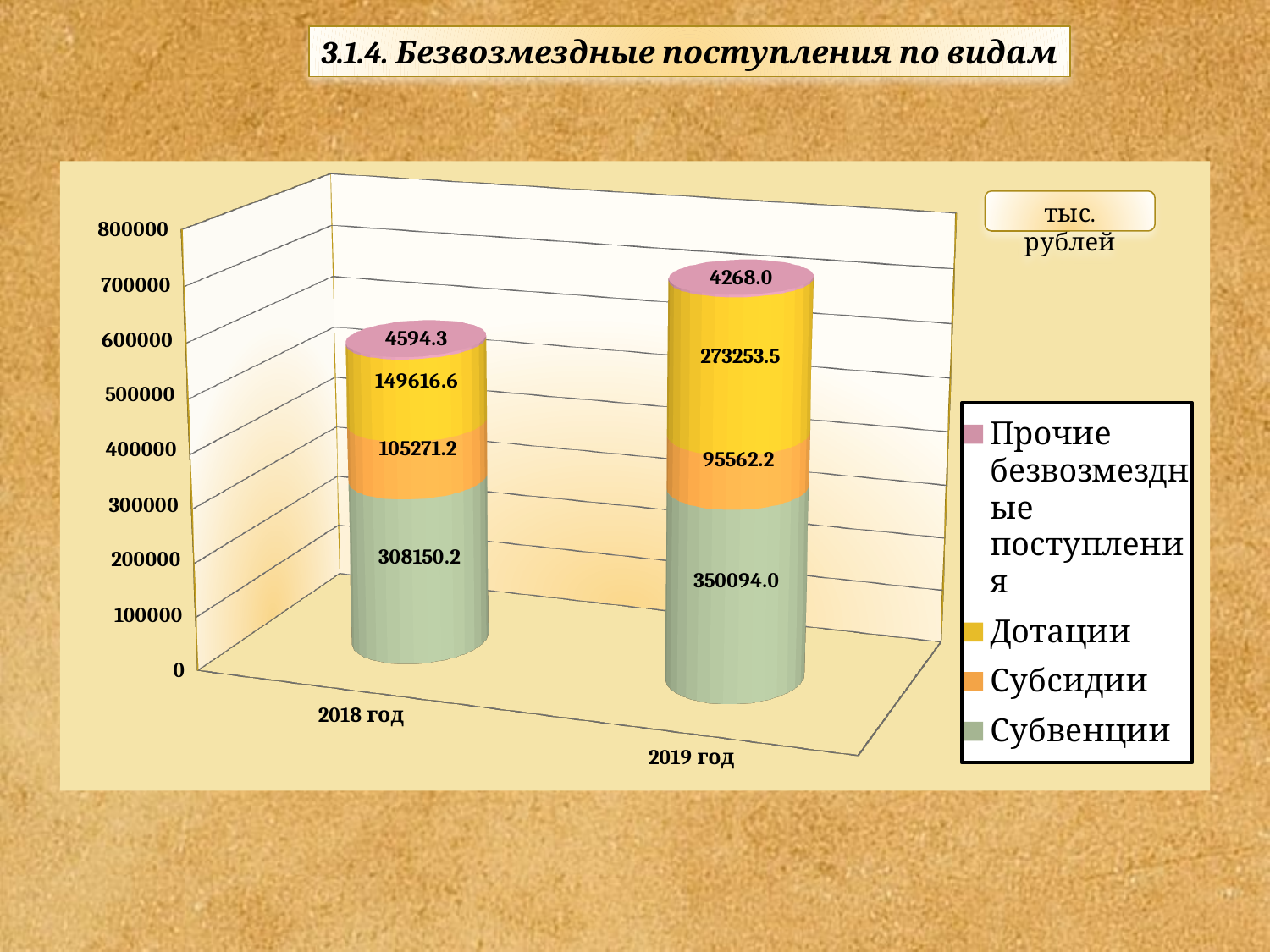
What is the value of Прочие безвозмездные поступления for 2018 год? 4594.3 What is the total of the stacked bar for 2019 год? 723177.7 Which year has the larger Субсидии value, 2018 год or 2019 год? 2018 год What is the value of Субвенции for 2018 год? 308150.2 What type of chart is shown on the slide? Stacked bar chart How many series does the legend list? 4 How many categories (years) are shown on the x axis? 2 What is the total of the stacked bar for 2018 год? 567632.3 What unit is indicated in the box at the top right of the chart? тыс. рублей What is the value of Дотации for 2019 год? 273253.5 What is the value of Субсидии for 2019 год? 95562.2 What is the difference between the Дотации values for 2019 год and 2018 год? 123636.9